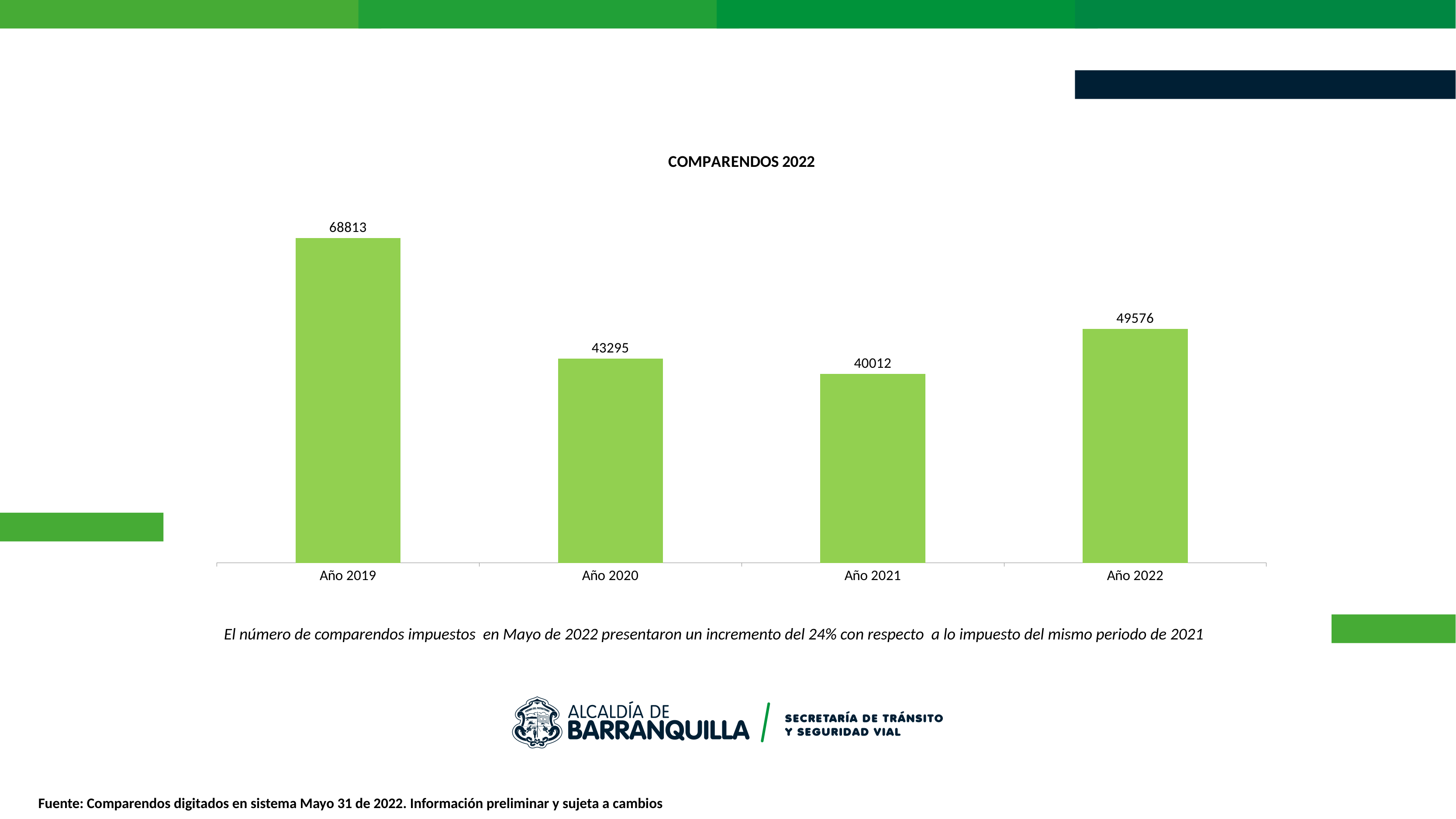
Which year has the highest value? Año 2019 What is the difference between the values for Año 2022 and Año 2021? 9564 What kind of chart is shown? Bar chart Which year has the lowest value? Año 2021 How many years are shown on the chart? 4 What is the value for Año 2020? 43295 What is the value for Año 2022? 49576 What is the value for Año 2021? 40012 Which is larger, the value for Año 2020 or the value for Año 2022? Año 2022 What is the title of the chart? COMPARENDOS 2022 What is the difference between the values for Año 2019 and Año 2022? 19237 What is the value for Año 2019? 68813